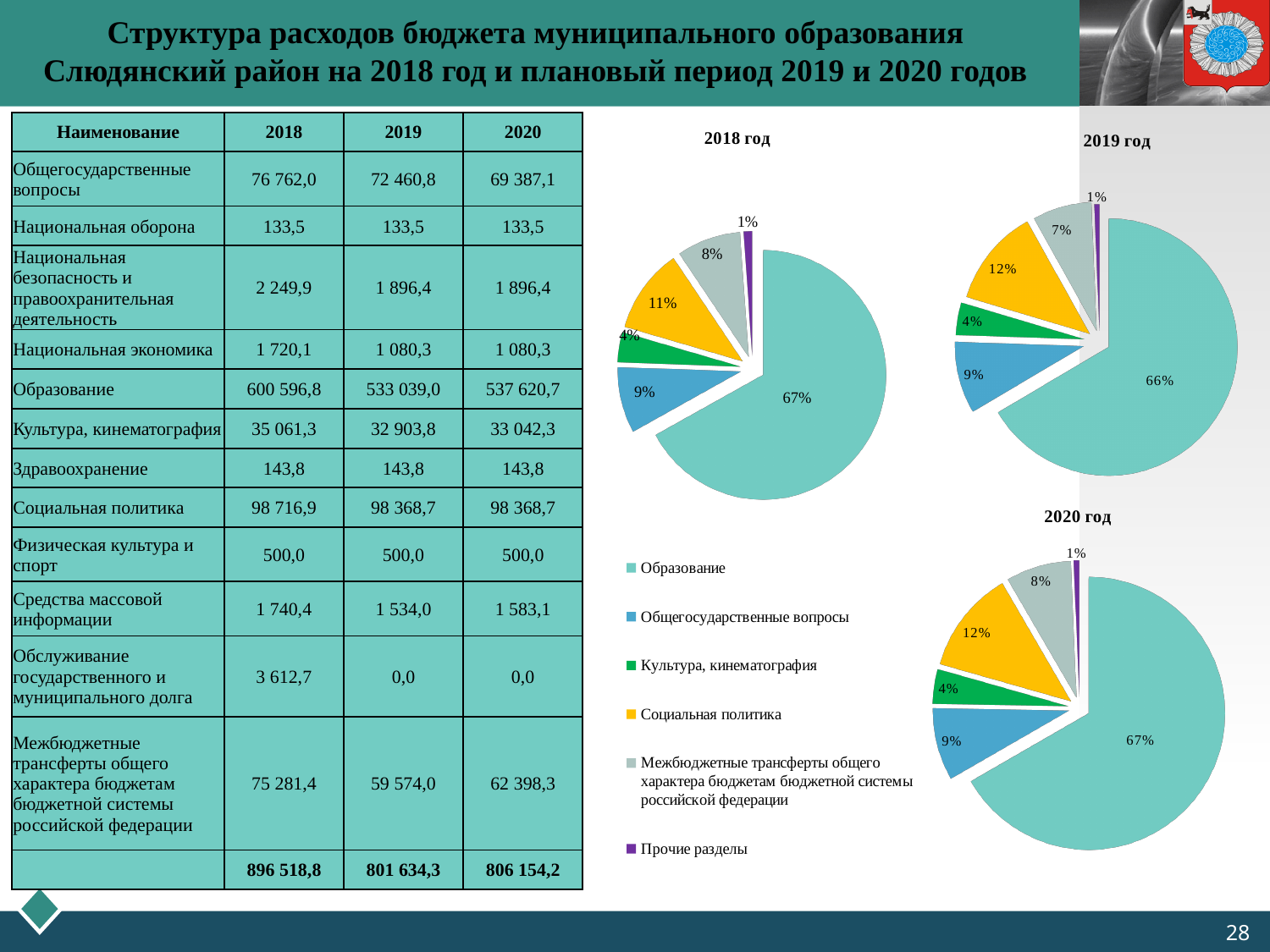
In the "2019 год" pie chart, what share does Образование have? 66% How many pie charts are shown on the slide? 3 In the "2018 год" pie chart, which category has the smallest slice? Прочие разделы In the "2018 год" pie chart, what share does Социальная политика have? 11% In the "2018 год" pie chart, what is the difference in percentage points between Социальная политика and Общегосударственные вопросы? 2 percentage points How many categories does the legend shared by the pie charts list? 6 In the "2019 год" pie chart, what share do Межбюджетные трансферты общего характера бюджетам бюджетной системы российской федерации have? 7% What kind of chart is the "2018 год" chart? pie chart In the "2020 год" pie chart, which category has the largest slice? Образование In the "2019 год" pie chart, which is larger: Общегосударственные вопросы or Культура, кинематография? Общегосударственные вопросы